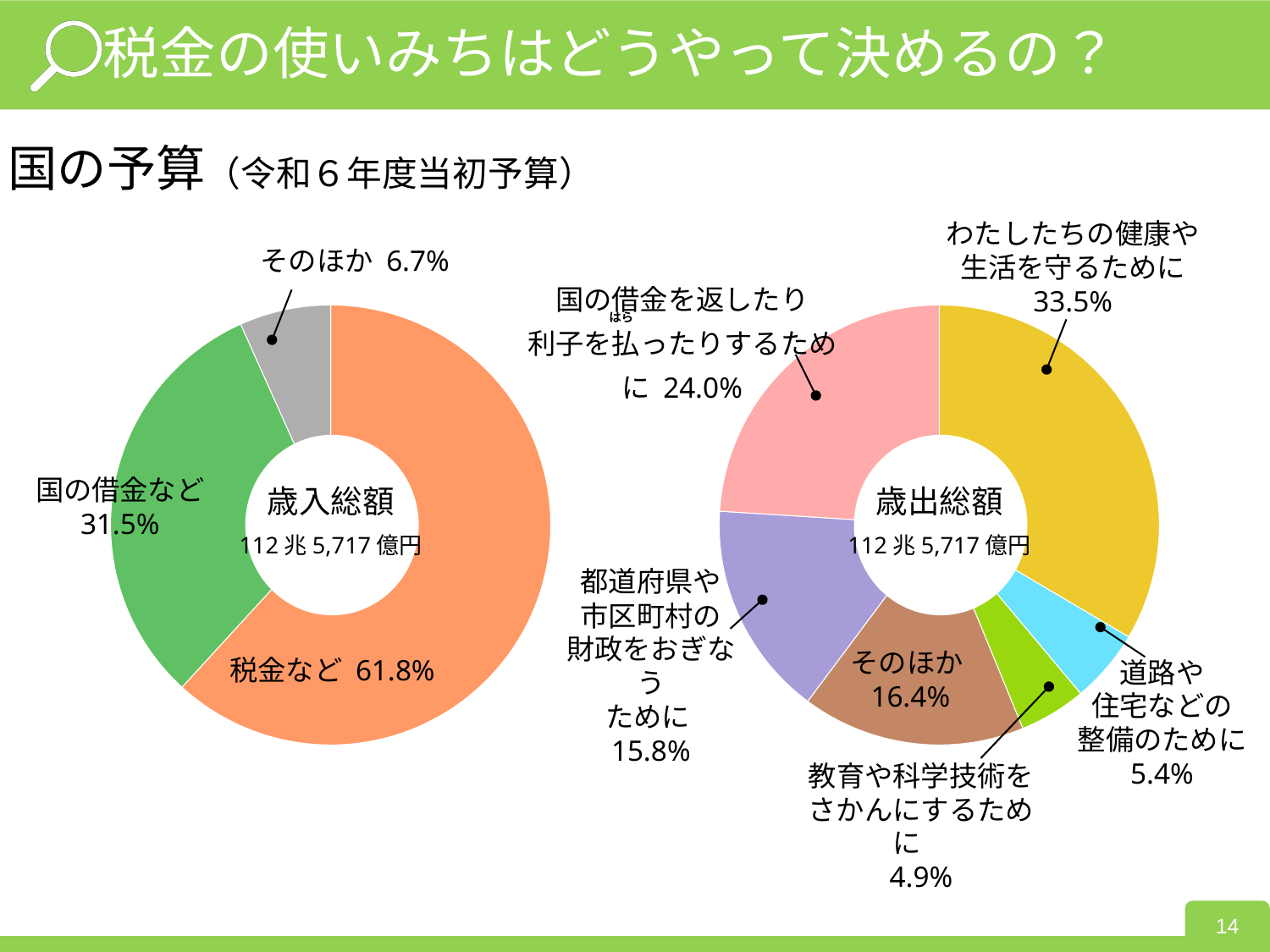
左の「歳入総額」のグラフで、「税金など」の割合はいくらですか？ 61.8% 左の「歳入総額」のグラフで、最も割合が小さい項目はどれですか？ そのほか 左の「歳入総額」のグラフの中央に示されている歳入総額はいくらですか？ 112兆5,717億円 右の「歳出総額」のグラフには、いくつの項目がありますか？ 6 右の「歳出総額」のグラフで、最も割合が小さい項目はどれですか？ 教育や科学技術をさかんにするために 左の「歳入総額」のグラフで、「税金など」と「国の借金など」の割合の差は何ポイントですか？ 30.3ポイント 右の「歳出総額」のグラフで、「そのほか」と「都道府県や市区町村の財政をおぎなうために」ではどちらの割合が大きいですか？ そのほか 右の「歳出総額」のグラフで、「わたしたちの健康や生活を守るために」の割合はいくらですか？ 33.5% このスライドのグラフはどの種類のグラフですか？ 円グラフ（ドーナツグラフ） 左の「歳入総額」のグラフで、「国の借金など」の割合はいくらですか？ 31.5% 右の「歳出総額」のグラフで、最も割合が大きい項目はどれですか？ わたしたちの健康や生活を守るために 右の「歳出総額」のグラフで、「国の借金を返したり利子を払ったりするために」の割合はいくらですか？ 24.0%